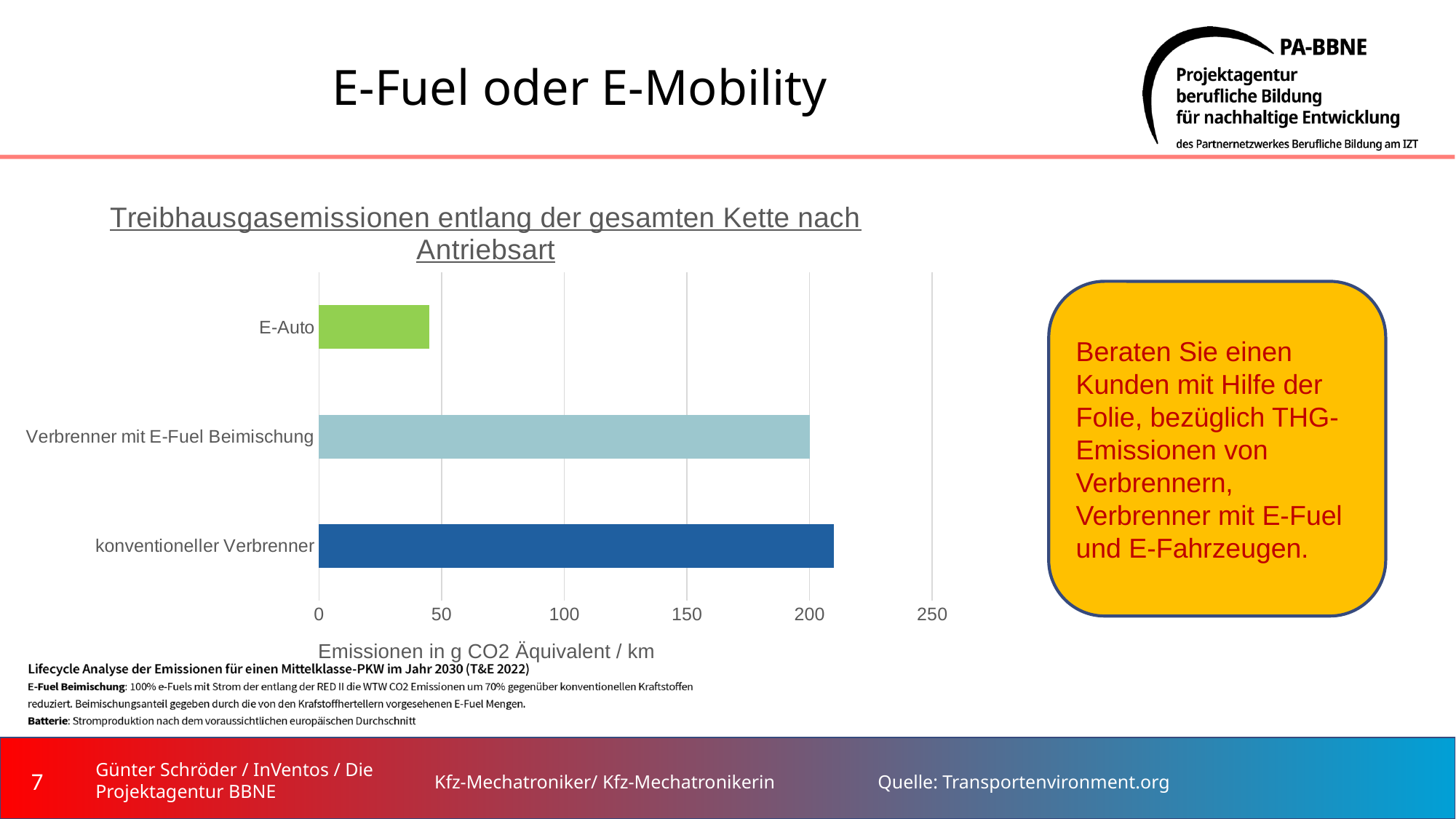
What is the title of the chart? Treibhausgasemissionen entlang der gesamten Kette nach Antriebsart Is the value for konventioneller Verbrenner greater or less than 200? greater What is the value for Verbrenner mit E-Fuel Beimischung in g CO2 Äquivalent / km? 200 Which category has the highest emissions in the chart? konventioneller Verbrenner Is the value for E-Auto greater or less than 50? less Which has higher emissions, E-Auto or Verbrenner mit E-Fuel Beimischung? Verbrenner mit E-Fuel Beimischung Is the value for Verbrenner mit E-Fuel Beimischung greater or less than 150? greater How many categories (drive types) are shown in the chart? 3 Which category has the lowest emissions in the chart? E-Auto Which has higher emissions, konventioneller Verbrenner or E-Auto? konventioneller Verbrenner What is the label of the horizontal axis of the chart? Emissionen in g CO2 Äquivalent / km What kind of chart is shown on the slide? bar chart